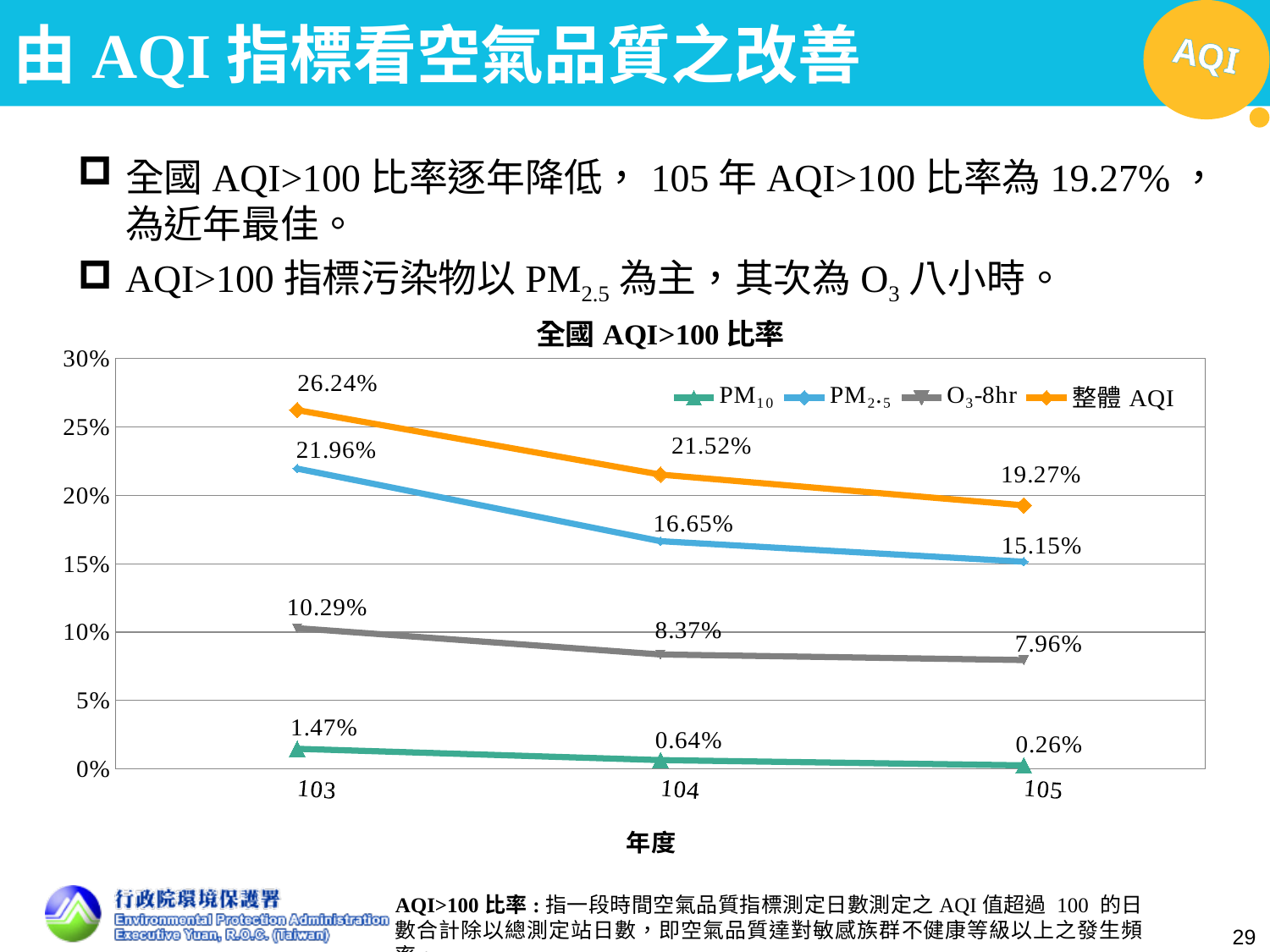
What is the PM10 value for year 105? 0.26% What type of chart is shown on the slide? line chart In which year is the 整體 AQI value highest? 103 Does the PM2.5 series rise or fall from year 103 to year 105? fall How many series does the legend list? 4 Which is larger in year 105: the PM2.5 value or the O3-8hr value? PM2.5 What is the 整體 AQI value for year 105? 19.27% What is the difference between the 整體 AQI values for years 103 and 105? 6.97% What is the O3-8hr value for year 103? 10.29% What is the PM2.5 value for year 104? 16.65% Which series has the lowest value in year 104? PM10 How many years are shown on the x axis? 3